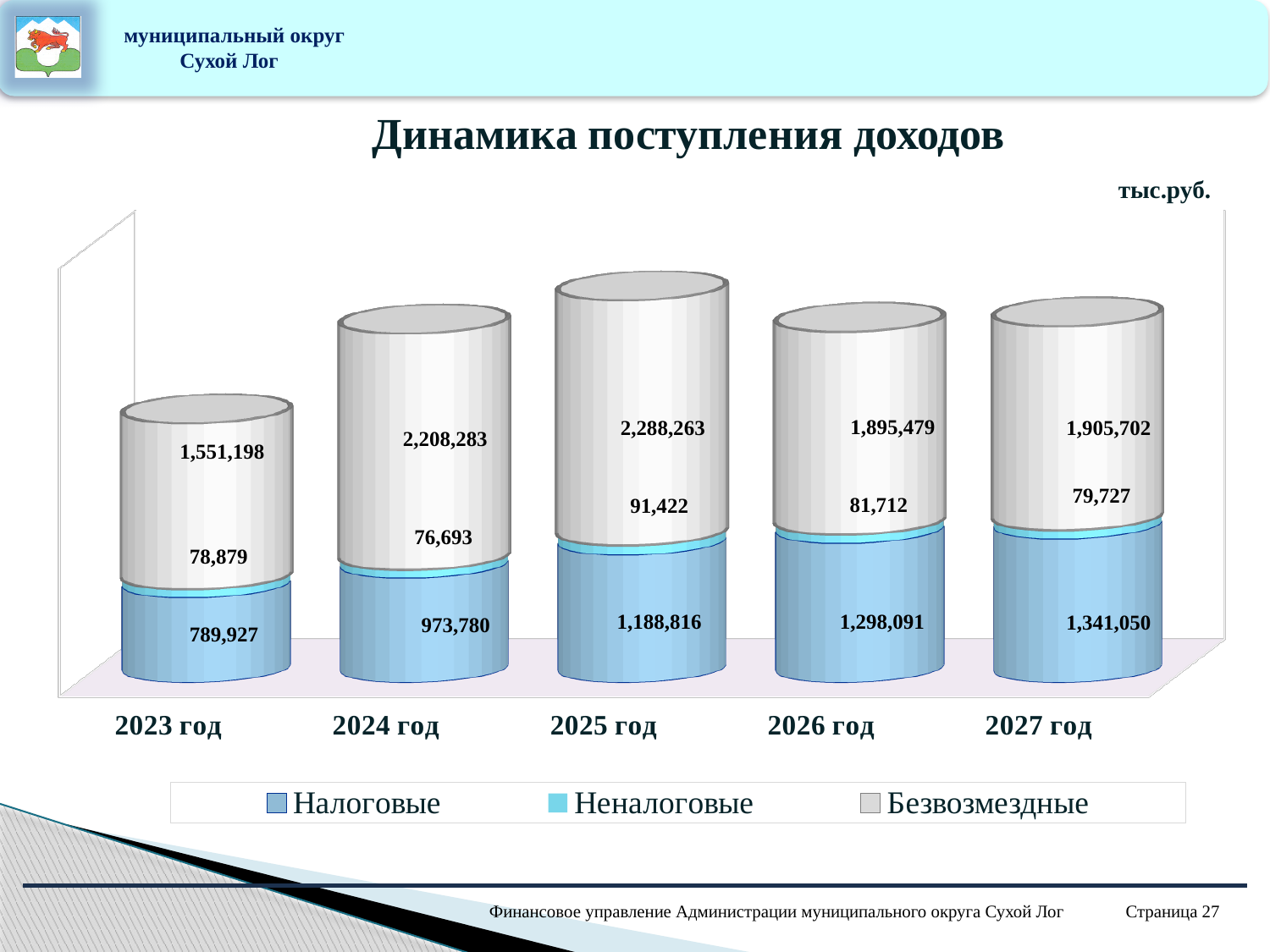
Which is larger: Безвозмездные in 2024 год or Безвозмездные in 2026 год? 2024 год What kind of chart is shown on the slide? Stacked bar chart How many years are shown on the x axis? 5 What is the difference between the Налоговые values for 2027 год and 2023 год? 551,123 In which year is the Неналоговые value lowest? 2024 год In which year is the Налоговые value highest? 2027 год In which year is the Неналоговые value highest? 2025 год What is the value for Безвозмездные in 2025 год? 2,288,263 What is the value for Налоговые in 2023 год? 789,927 What is the value for Неналоговые in 2027 год? 79,727 Do the Налоговые values rise or fall from 2023 год to 2027 год? Rise How many series does the legend list? 3